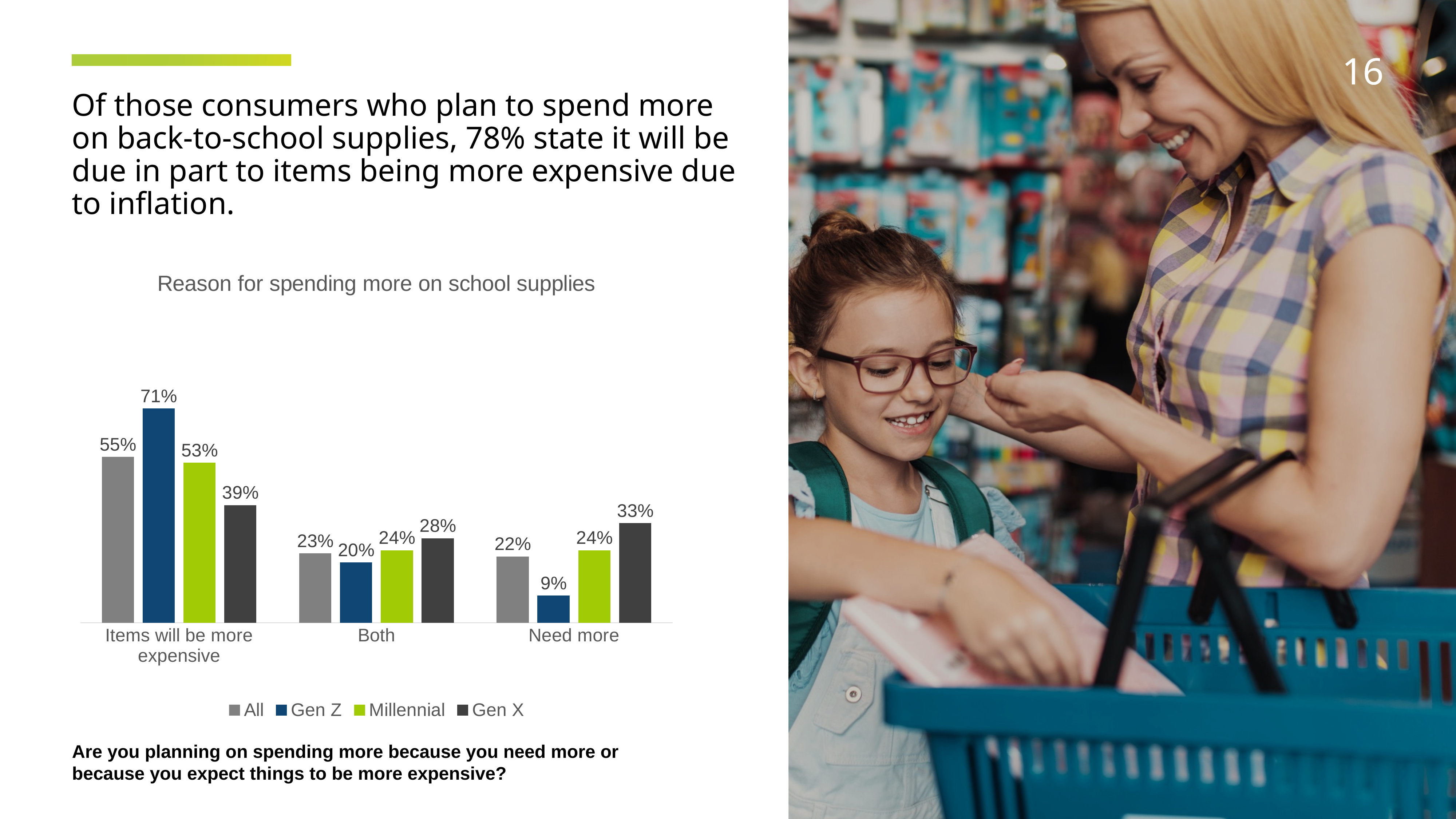
How many series does the legend list? 4 How many categories are shown on the x axis? 3 Which series has the lowest value in the 'Need more' category? Gen Z Which series has the highest value in the 'Items will be more expensive' category? Gen Z What is the value for Millennial in the 'Items will be more expensive' category? 53% What is the value for Gen X in the 'Need more' category? 33% Which is larger: the Gen X value for 'Both' or the Gen X value for 'Need more'? Need more What is the title of the chart? Reason for spending more on school supplies What is the value for All in the 'Both' category? 23% What is the value for Gen Z in the 'Items will be more expensive' category? 71% What is the difference between the Gen Z and Gen X values in the 'Items will be more expensive' category? 32% What kind of chart is shown on the slide? Bar chart